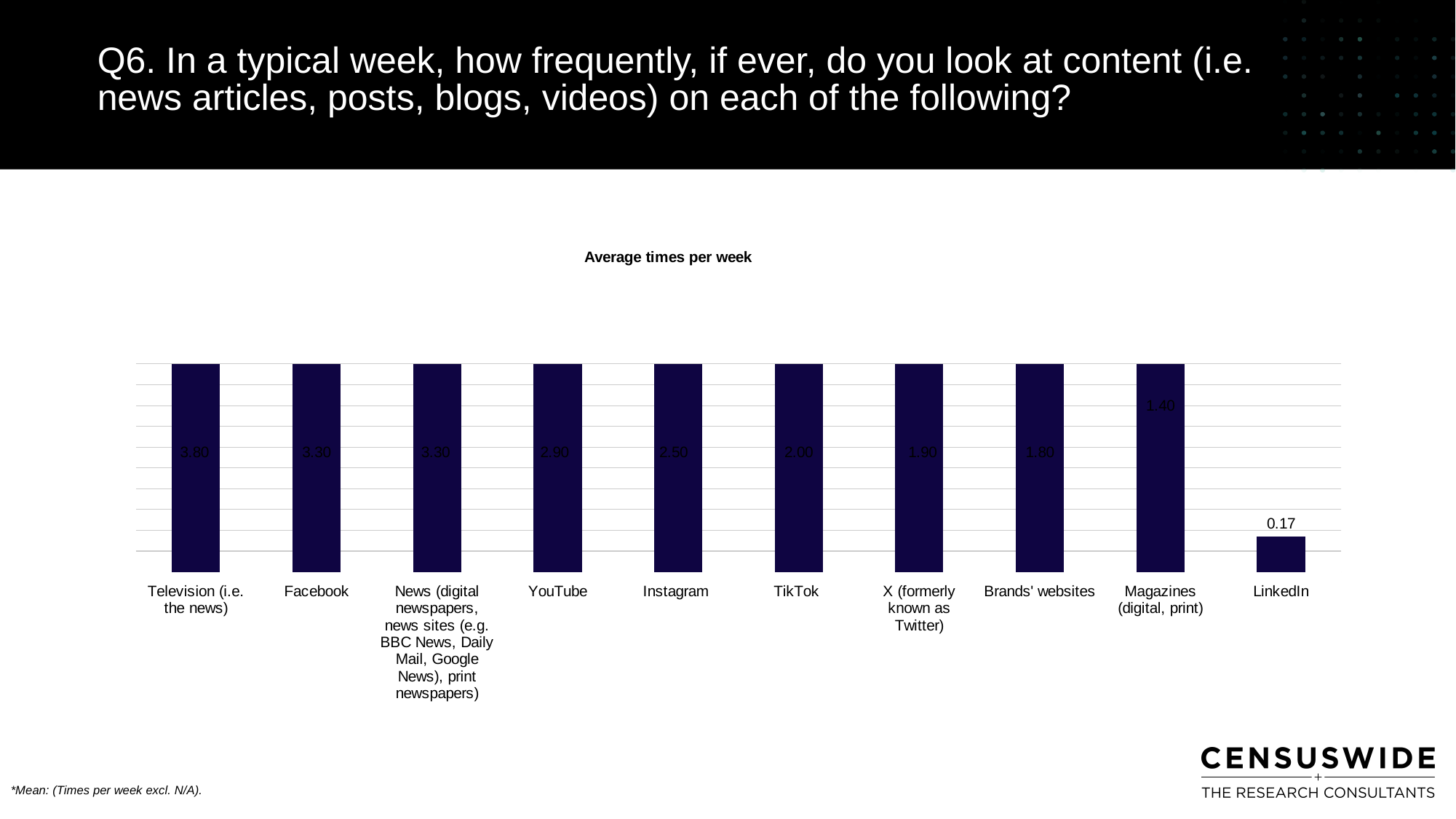
Which category has the lowest average times per week? LinkedIn What is the average times per week for Magazines (digital, print)? 1.40 What is the average times per week for YouTube? 2.90 What type of chart is shown on the slide? Bar chart What is the difference between the values for TikTok and Brands' websites? 0.20 Which category has the highest average times per week? Television (i.e. the news) What is the average times per week for LinkedIn? 0.17 How many categories are shown on the chart? 10 Which has a higher value, Instagram or TikTok? Instagram What is the average times per week for Television (i.e. the news)? 3.80 What is the difference between the values for Television (i.e. the news) and Facebook? 0.50 What is the title of the chart? Average times per week